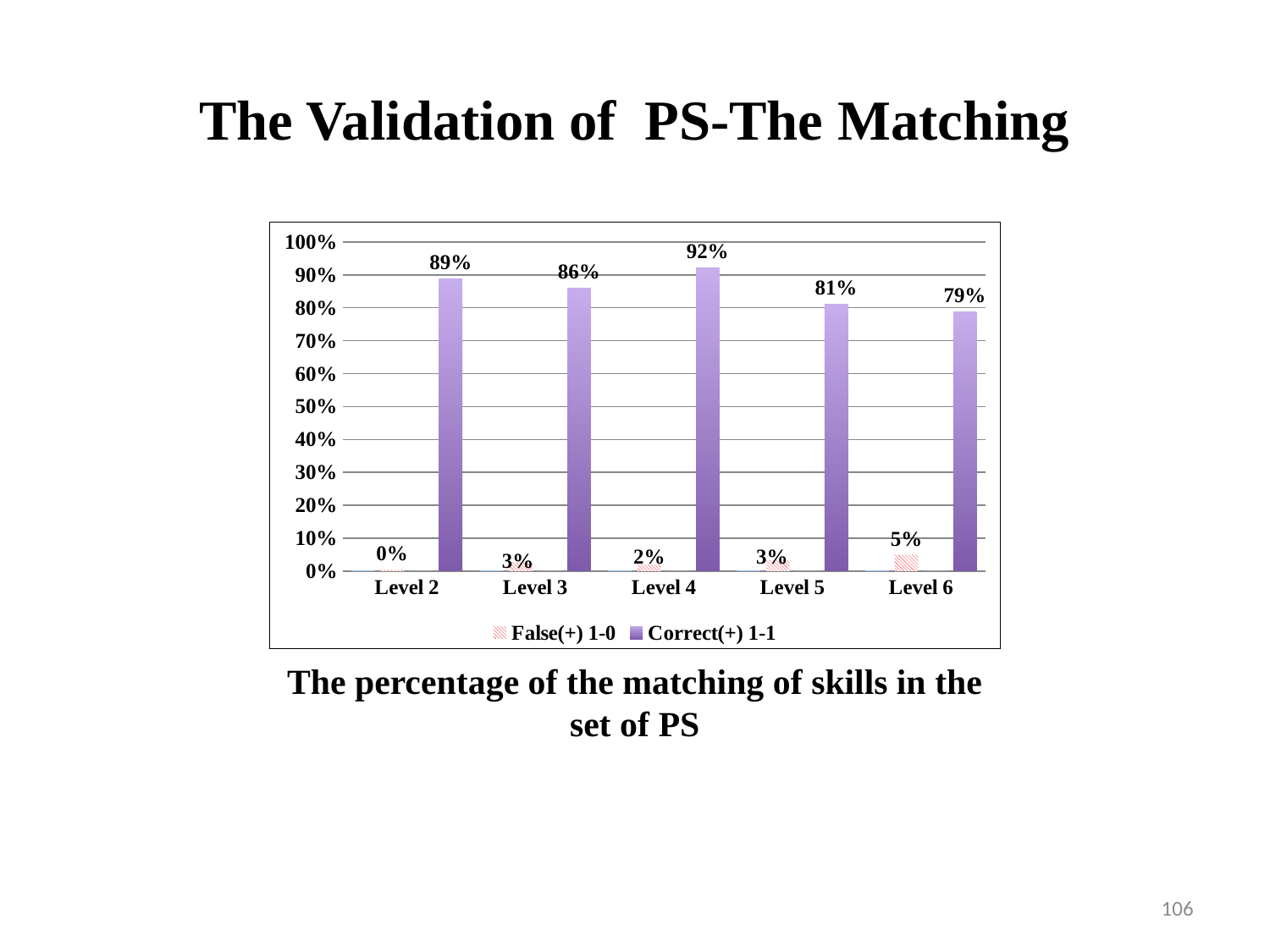
What is the caption below the chart? The percentage of the matching of skills in the set of PS How many series does the legend list? 2 What is the False(+) 1-0 value for Level 6? 5% What kind of chart is shown on the slide? Bar chart What is the Correct(+) 1-1 value for Level 6? 79% What is the difference between the Correct(+) 1-1 values for Level 2 and Level 5? 8% Which level has the highest Correct(+) 1-1 value? Level 4 Which level has the lowest False(+) 1-0 value? Level 2 Which level has the lowest Correct(+) 1-1 value? Level 6 How many levels are shown on the x axis? 5 Which is larger, the Correct(+) 1-1 value for Level 3 or for Level 5? Level 3 What is the Correct(+) 1-1 value for Level 4? 92%